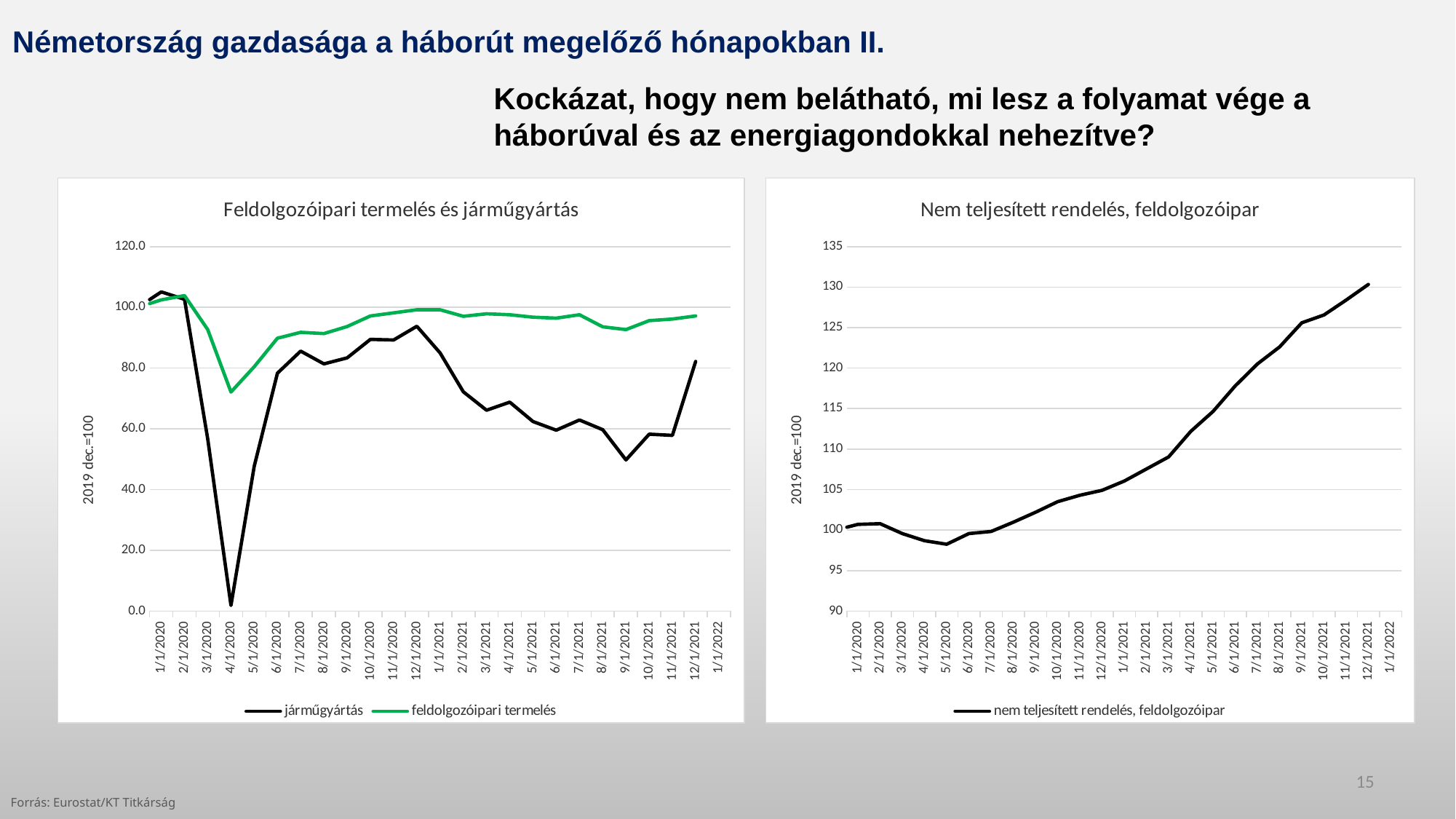
In the right chart "Nem teljesített rendelés, feldolgozóipar", is the value at 12/1/2021 greater or less than 125? greater What is the title of the right chart? Nem teljesített rendelés, feldolgozóipar In the left chart "Feldolgozóipari termelés és járműgyártás", what colour is the feldolgozóipari termelés line? green In the left chart "Feldolgozóipari termelés és járműgyártás", which series has the higher value at 9/1/2021, járműgyártás or feldolgozóipari termelés? feldolgozóipari termelés In the left chart "Feldolgozóipari termelés és járműgyártás", is the járműgyártás value at 4/1/2020 greater or less than 20.0? less How many series does the legend of the right chart "Nem teljesített rendelés, feldolgozóipar" list? 1 In the left chart "Feldolgozóipari termelés és járműgyártás", is the feldolgozóipari termelés value at 4/1/2020 greater or less than 80.0? less How many series does the legend of the left chart "Feldolgozóipari termelés és járműgyártás" list? 2 In the left chart "Feldolgozóipari termelés és járműgyártás", at which date does the járműgyártás series reach its lowest value? 4/1/2020 In the right chart "Nem teljesített rendelés, feldolgozóipar", at which date is the value highest? 12/1/2021 What type of chart is the left chart titled "Feldolgozóipari termelés és járműgyártás"? line chart In the right chart "Nem teljesített rendelés, feldolgozóipar", do the values generally rise or fall from 7/1/2020 to 12/1/2021? rise